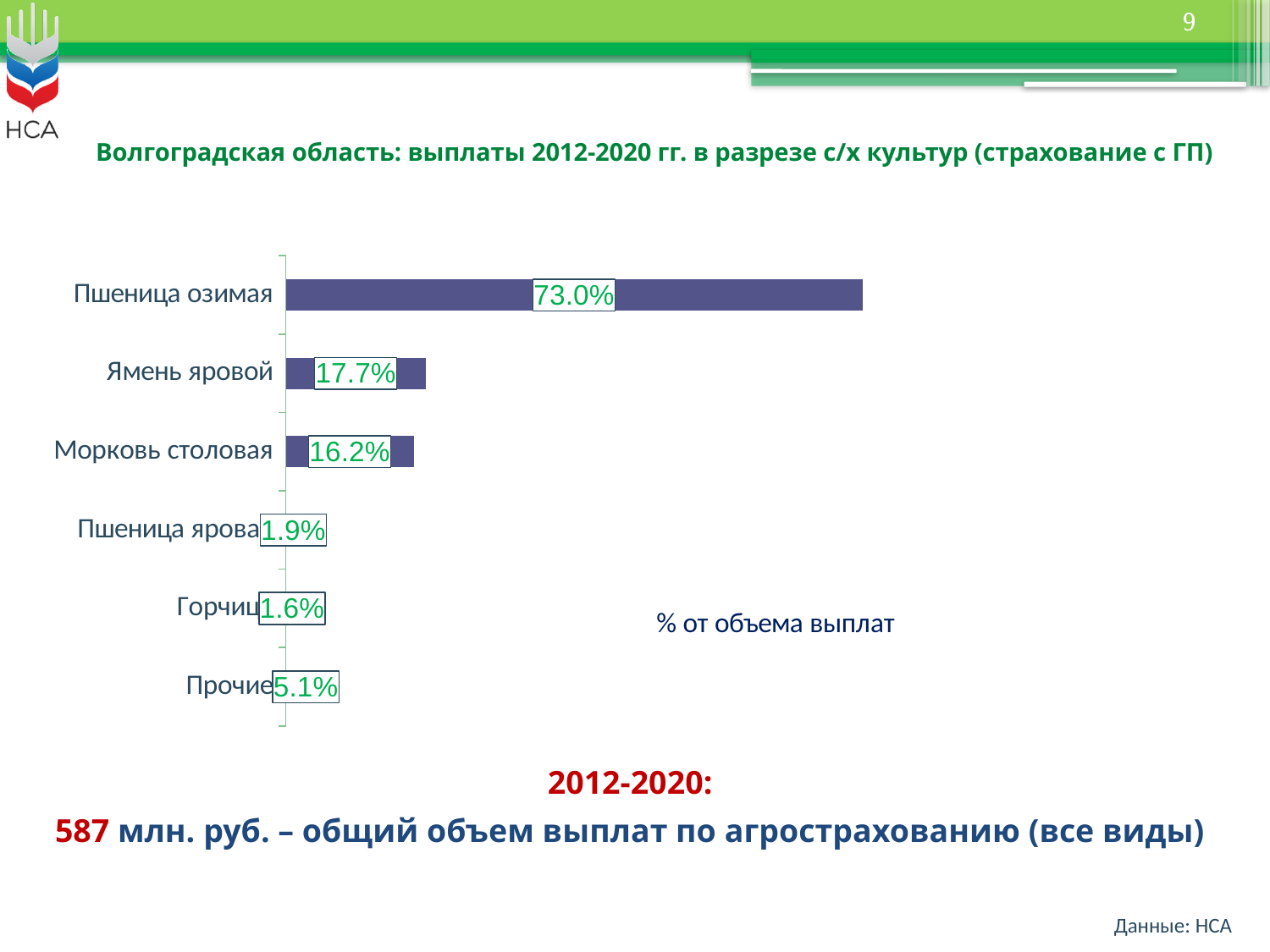
What is the value for Ямень яровой? 17.7% Which is larger, the value for Прочие or the value for Пшеница яровая? Прочие What is the value for Морковь столовая? 16.2% What kind of chart is shown on the slide? Bar chart What is the value for Прочие? 5.1% What is the difference between the values for Пшеница озимая and Ямень яровой? 55.3% How many categories are shown in the chart? 6 Which category has the lowest value? Горчица Which category has the highest value? Пшеница озимая What is the value for Пшеница озимая? 73.0% What is the text label shown next to the chart describing the values? % от объема выплат What is the difference between the values for Ямень яровой and Морковь столовая? 1.5%